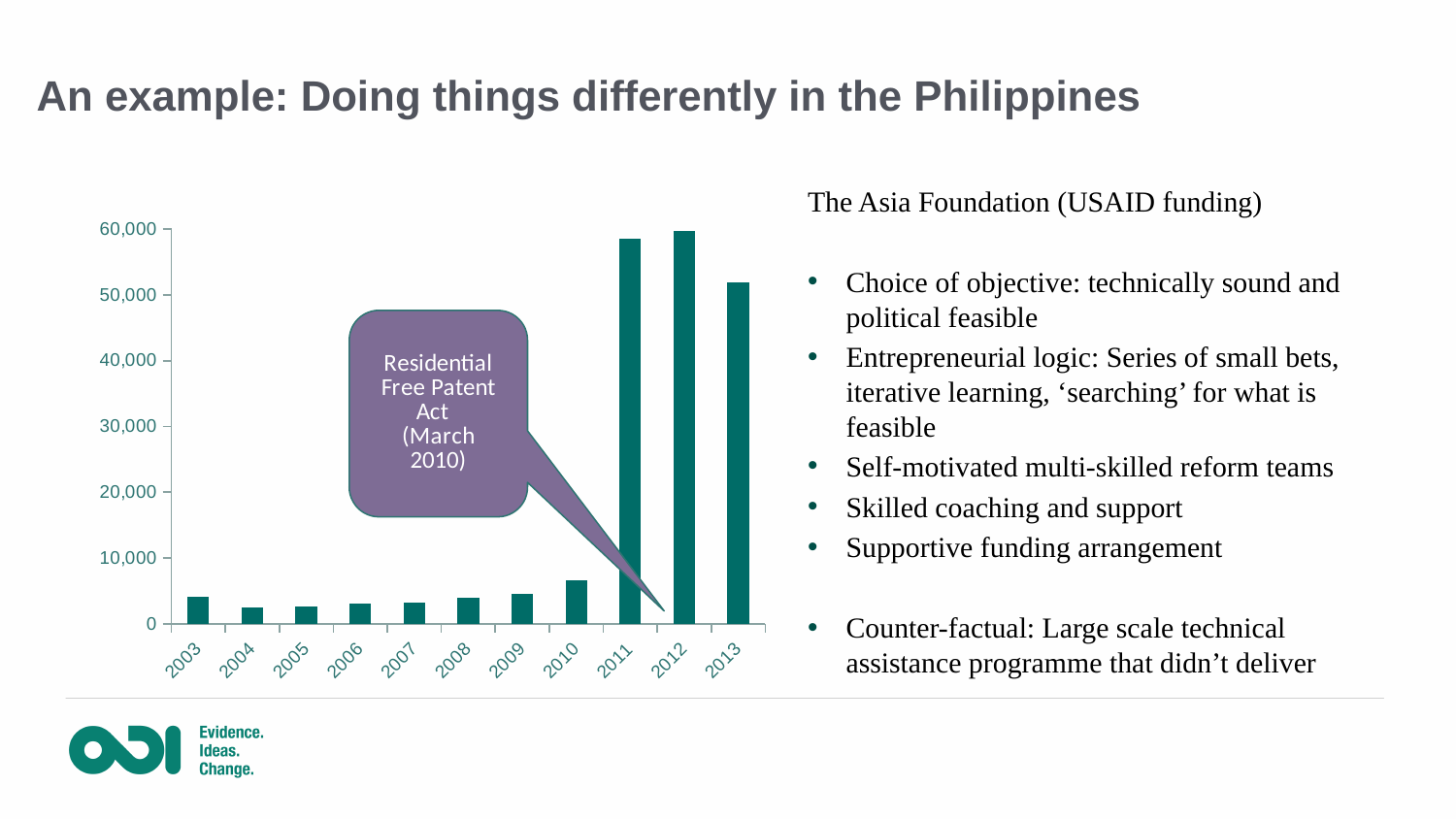
Which year has the larger value, 2011 or 2013? 2011 Do the values generally rise or fall from 2003 to 2012? rise How many years are shown on the x axis of the chart? 11 Is the value for 2011 greater or less than 40,000? greater Is the value for 2012 greater or less than 50,000? greater Which year has the larger value, 2013 or 2009? 2013 Is the value for 2003 greater or less than 10,000? less What kind of chart is shown on the slide? bar chart Which year has the larger value, 2010 or 2004? 2010 What event does the callout on the chart label? Residential Free Patent Act (March 2010)